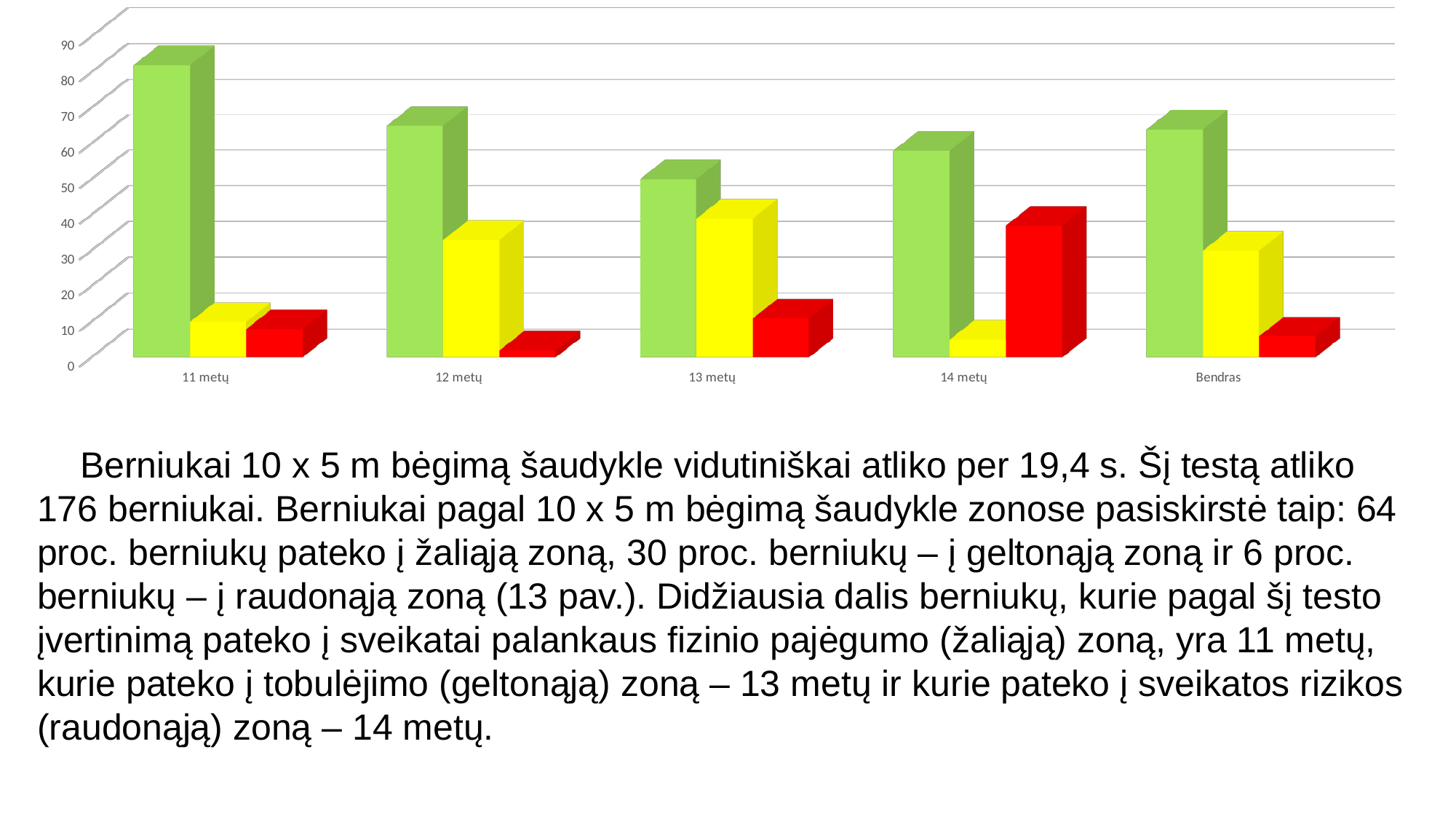
What kind of chart is shown on the slide? bar chart Is the yellow bar for 11 metų greater or less than 20? less Which category has the tallest red bar? 14 metų What three colours are used for the bars in the chart? green, yellow and red Is the red bar for 14 metų greater or less than 30? greater Which category has the shortest red bar? 12 metų How many bars are plotted for each category in the chart? 3 Is the green bar for 11 metų greater or less than 70? greater Which category has the tallest green bar? 11 metų How many categories are shown on the x axis of the chart? 5 In the 14 metų category, which is larger, the red bar or the yellow bar? the red bar Which category has the shortest yellow bar? 14 metų